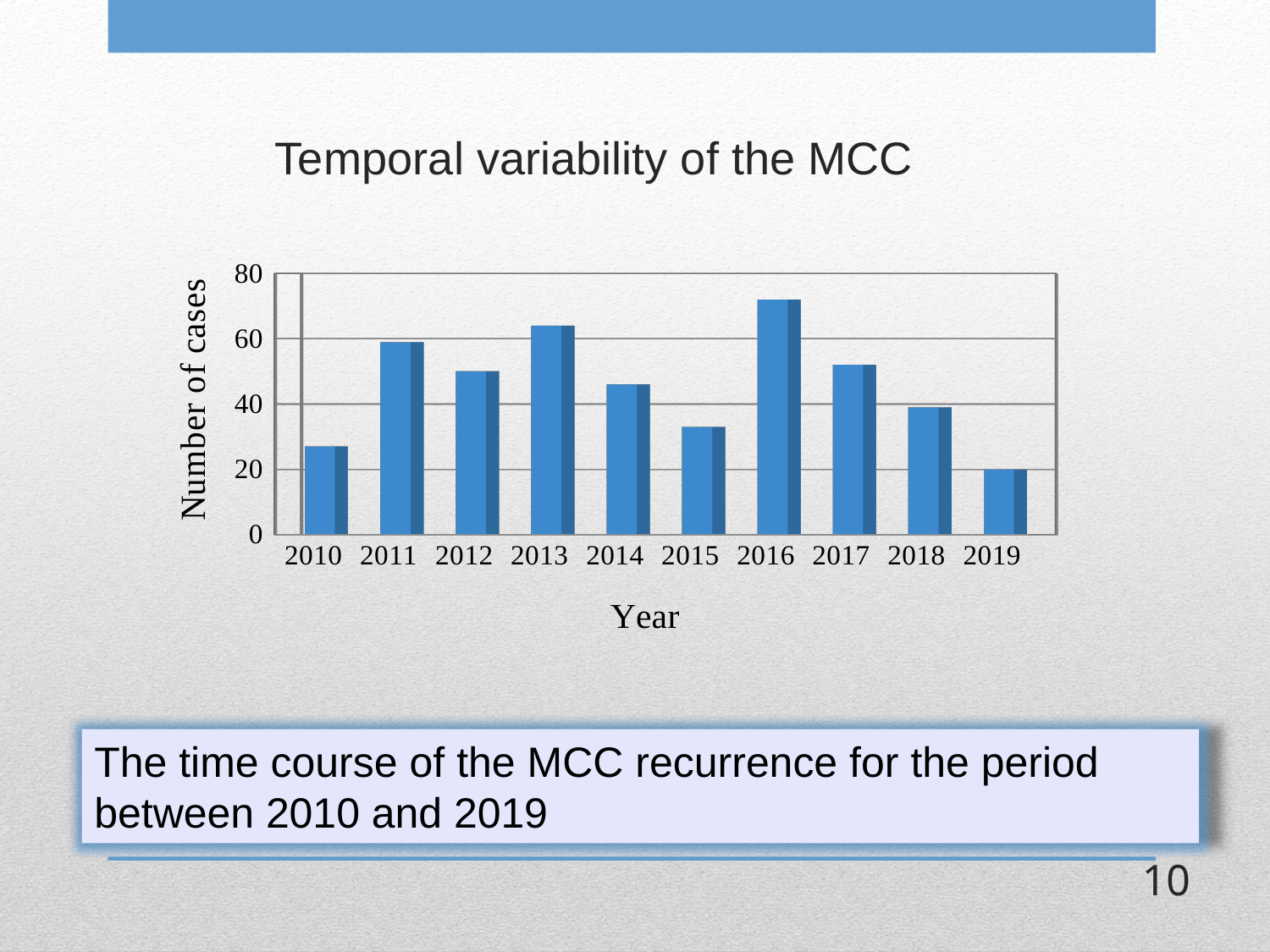
What is the label of the x axis? Year What is the label of the y axis? Number of cases Is the number of cases in 2017 greater or less than 40? greater Is the number of cases in 2016 greater or less than 60? greater Which year has the lowest number of cases? 2019 Which year has more cases, 2013 or 2016? 2016 Is the number of cases in 2015 greater or less than 40? less Which year has the highest number of cases? 2016 What kind of chart is shown on the slide? bar chart How many years are shown on the x axis of the chart? 10 Which year has more cases, 2010 or 2019? 2010